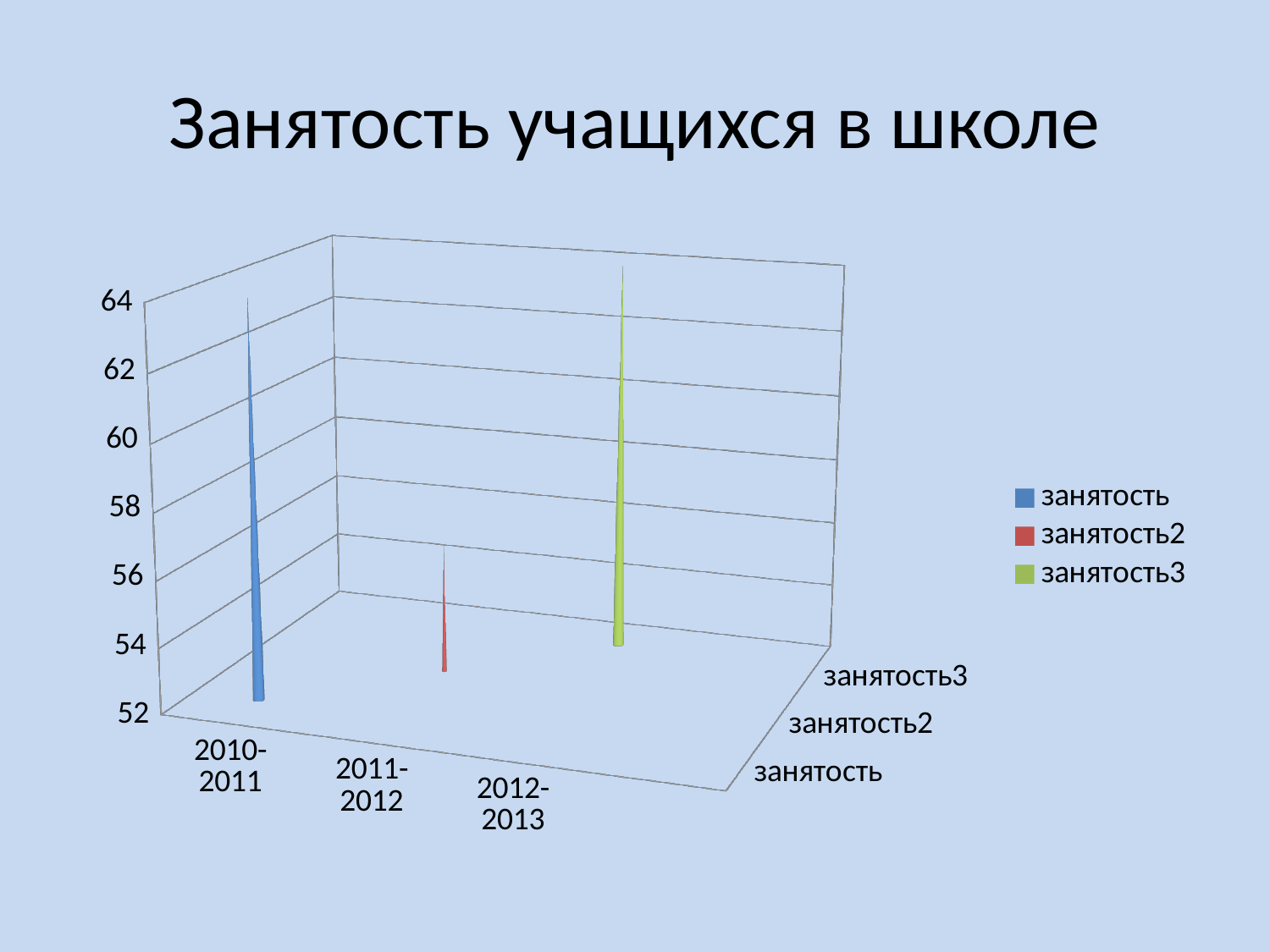
Which school year has the lowest value? 2011-2012 How many school-year categories are shown on the x axis? 3 What is the title of the chart? Занятость учащихся в школе Is the value for 2012-2013 greater or less than 58? greater Which series has the lowest value? занятость2 What colour represents the series занятость3 in the legend? green What kind of chart is shown on the slide? bar chart How many series does the legend list? 3 Is the value for 2011-2012 greater or less than 60? less Which is larger, the value for 2010-2011 or the value for 2011-2012? 2010-2011 Is the value for 2010-2011 greater or less than 56? greater Which is larger, the value for 2012-2013 or the value for 2011-2012? 2012-2013